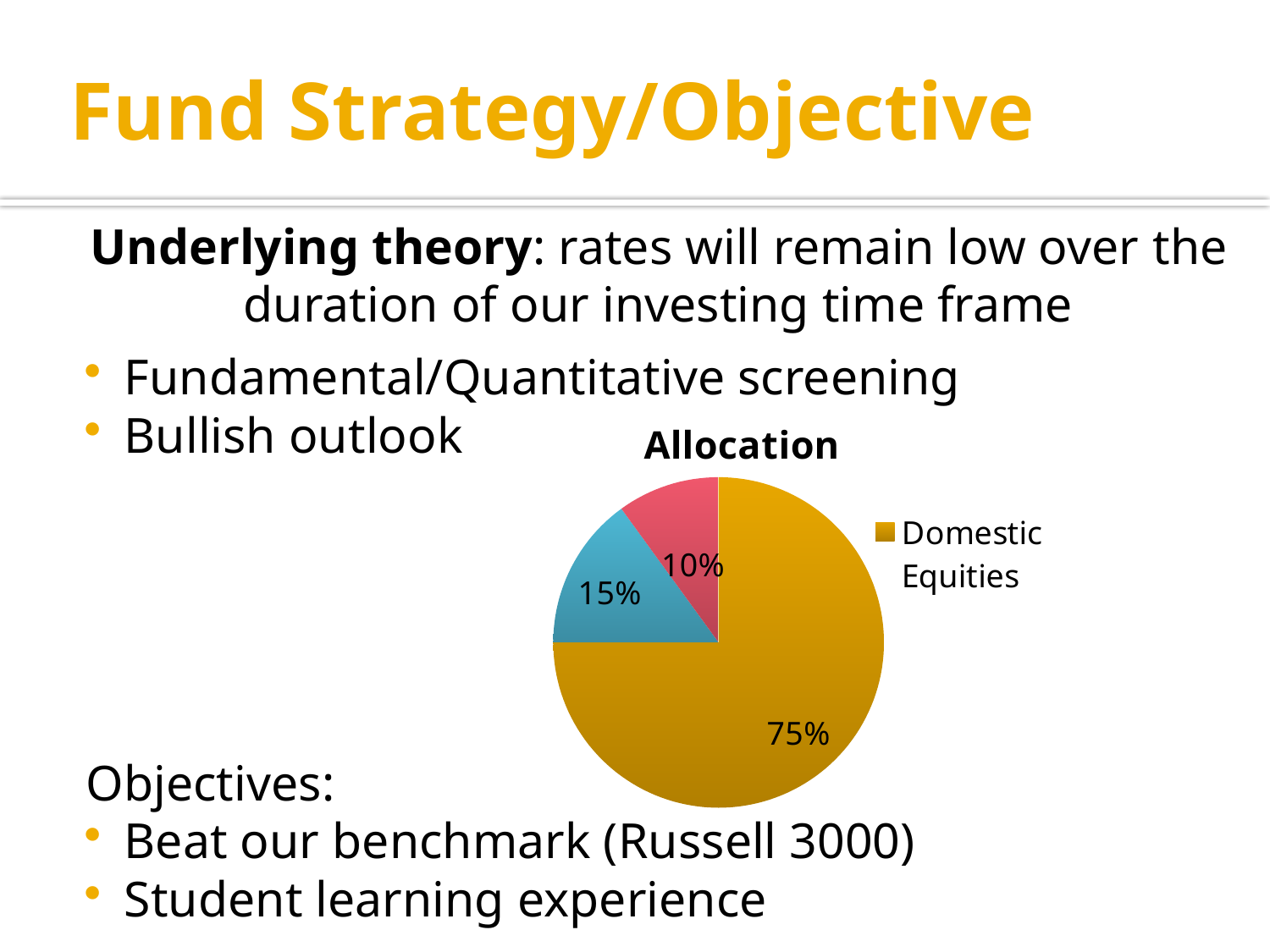
What is the value of the largest slice in the Allocation pie chart? 75% What is the value of the smallest slice in the Allocation pie chart? 10% How many entries does the legend of the Allocation chart list? 1 What kind of chart is shown on the slide? pie chart What colour is the Domestic Equities slice in the Allocation pie chart? gold What is the difference between the 15% slice and the 10% slice in the Allocation pie chart? 5% What is the title of the chart? Allocation Which category has the largest slice in the Allocation pie chart? Domestic Equities What share of the Allocation pie is Domestic Equities? 75% What is the difference between the largest and smallest slices in the Allocation pie chart? 65% How many slices does the Allocation pie chart have? 3 Which is larger in the Allocation pie chart, the blue slice or the red slice? the blue slice